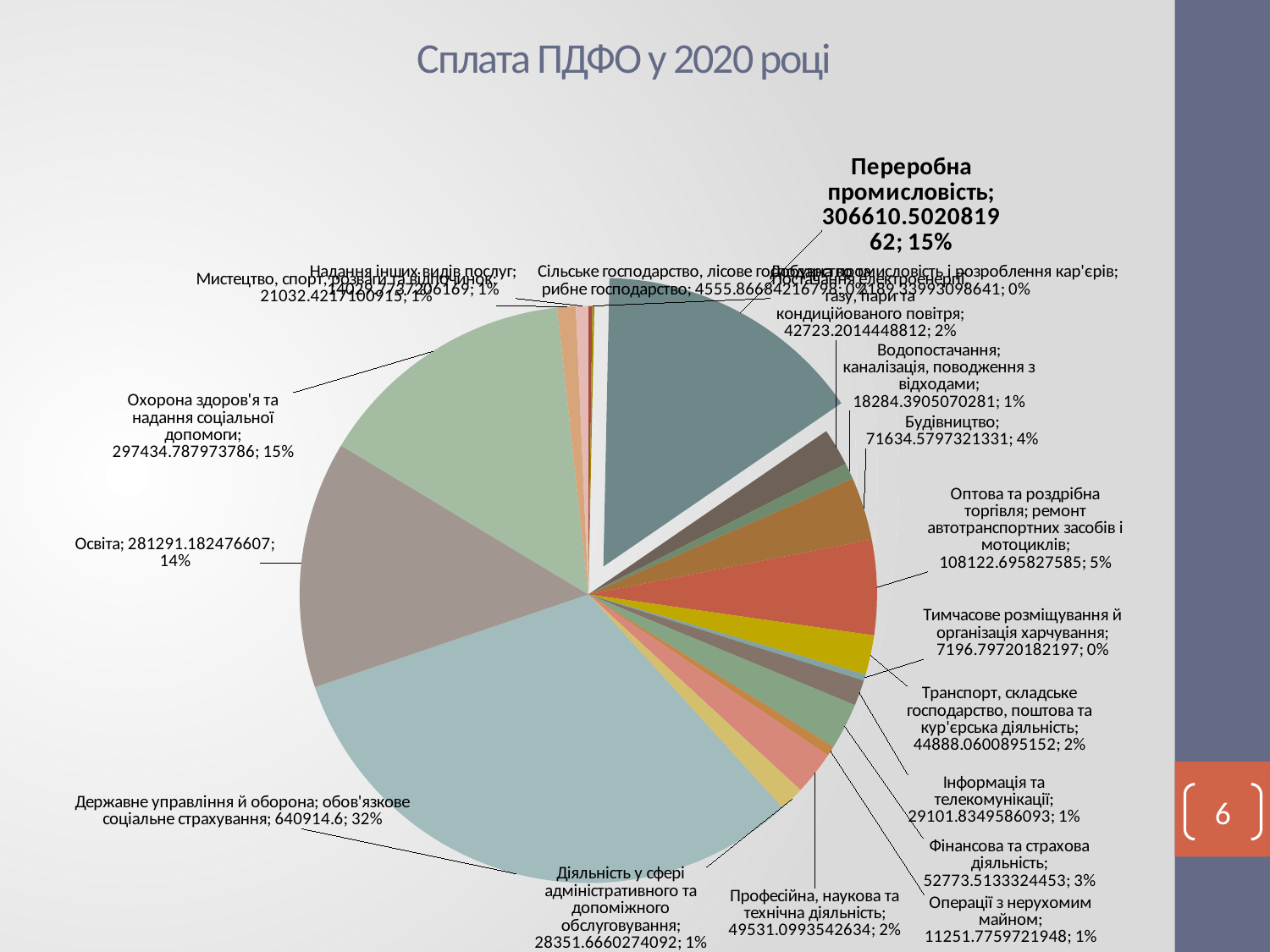
What is the difference between the values for Будівництво and Фінансова та страхова діяльність? 18861.0663996878 What is the value for Освіта? 281291.182476607 What is the value for Фінансова та страхова діяльність? 52773.5133324453 What is the value for Будівництво? 71634.5797321331 What is the value for Оптова та роздрібна торгівля; ремонт автотранспортних засобів і мотоциклів? 108122.695827585 Which category has the largest share of the pie? Державне управління й оборона; обов'язкове соціальне страхування What share of the pie does Переробна промисловість have? 15% What kind of chart is shown on the slide? pie chart Which is larger, the value for Охорона здоров'я та надання соціальної допомоги or the value for Освіта? Охорона здоров'я та надання соціальної допомоги What share of the pie does Державне управління й оборона; обов'язкове соціальне страхування have? 32% What is the title of the chart? Сплата ПДФО у 2020 році What share of the pie does Транспорт, складське господарство, поштова та кур'єрська діяльність have? 2%